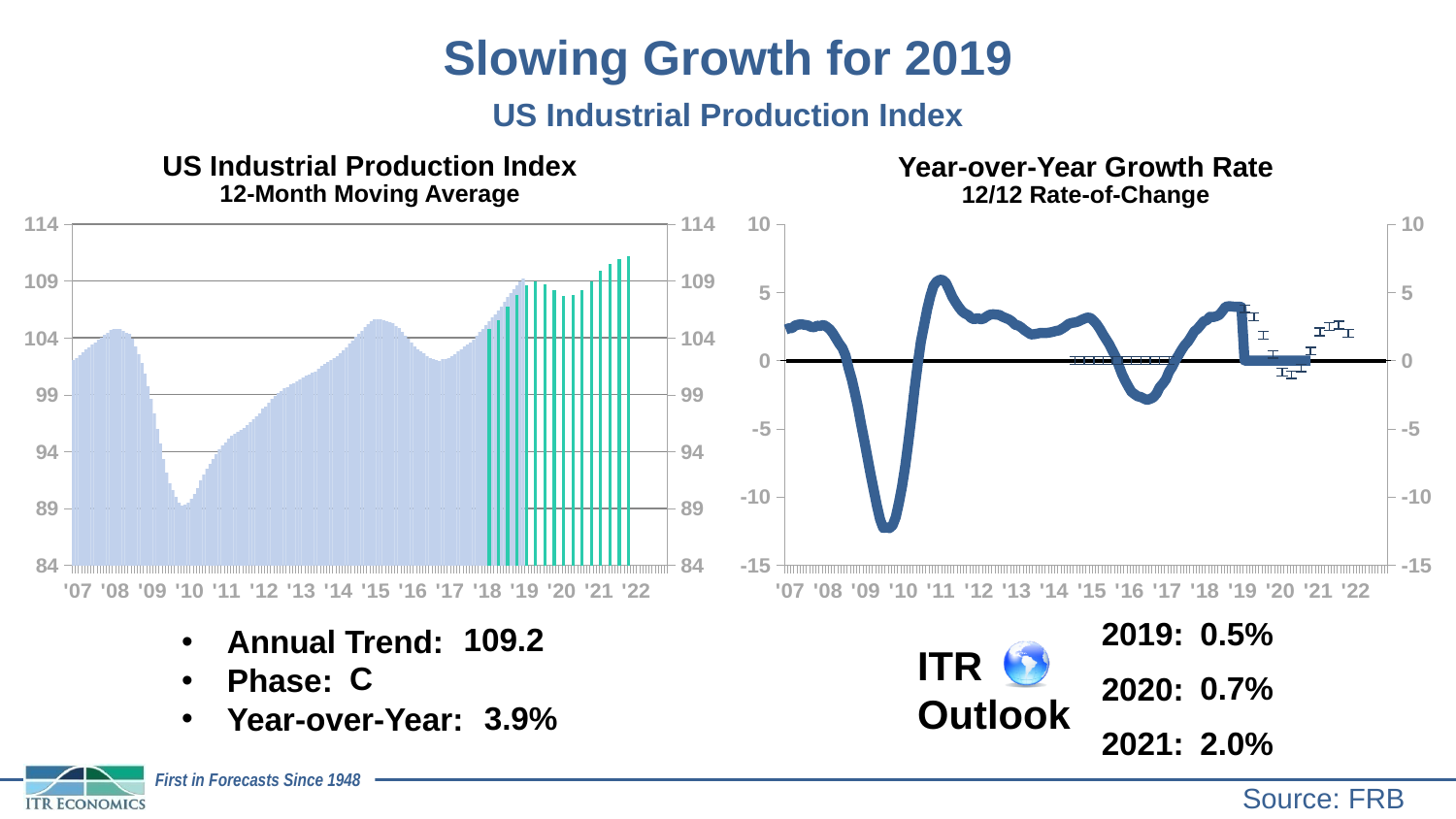
How many year labels are shown on the x axis of the left chart? 16 What is the subtitle of the left chart? 12-Month Moving Average What kind of chart is the right chart titled 'Year-over-Year Growth Rate 12/12 Rate-of-Change'? line chart On the right chart, is the value at the low point around '16 greater or less than 0? less On the left chart, do the values rise or fall from '09 to '15? rise On the left chart, is the value at the peak around '15 greater or less than 104? greater On the right chart, is the value at the trough in '09 greater or less than -10? less On the right chart, do the values rise or fall from '11 to '16? fall What kind of chart is the left chart titled 'US Industrial Production Index 12-Month Moving Average'? bar chart What is the highest value shown on the vertical axis of the right chart? 10